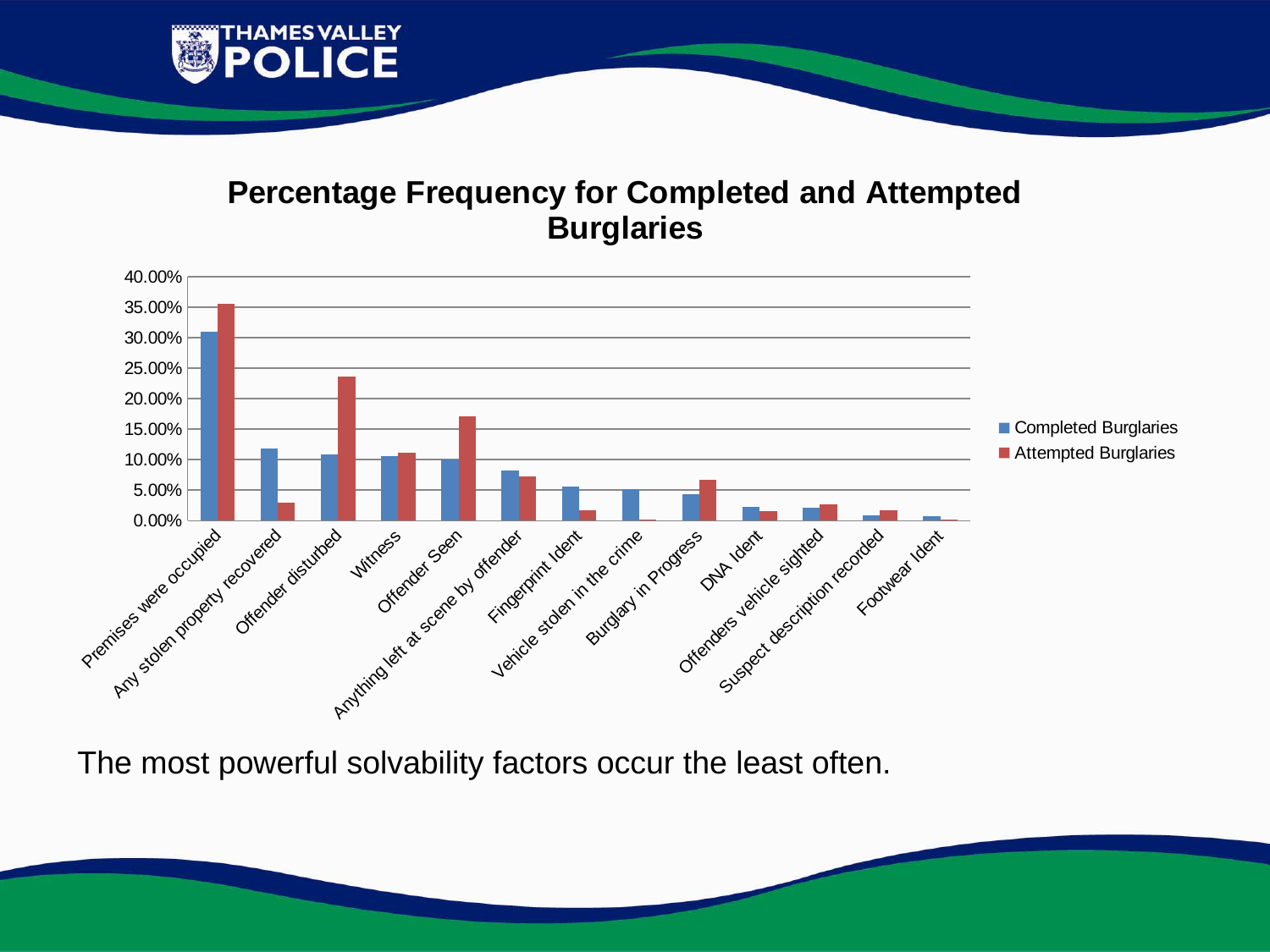
For Offender disturbed, which series has the larger value, Completed Burglaries or Attempted Burglaries? Attempted Burglaries How many series does the legend list? 2 Which category has the highest value for Completed Burglaries? Premises were occupied Is the Attempted Burglaries value for Any stolen property recovered greater or less than 5.00%? less What colour are the Completed Burglaries bars? Blue Is the Completed Burglaries value for Premises were occupied greater or less than 25.00%? greater Which category has the highest value for Attempted Burglaries? Premises were occupied How many categories are shown on the x axis? 13 Is the Completed Burglaries value for Fingerprint Ident greater or less than 10.00%? less What kind of chart is shown on the slide? Bar chart For Any stolen property recovered, which series has the larger value, Completed Burglaries or Attempted Burglaries? Completed Burglaries